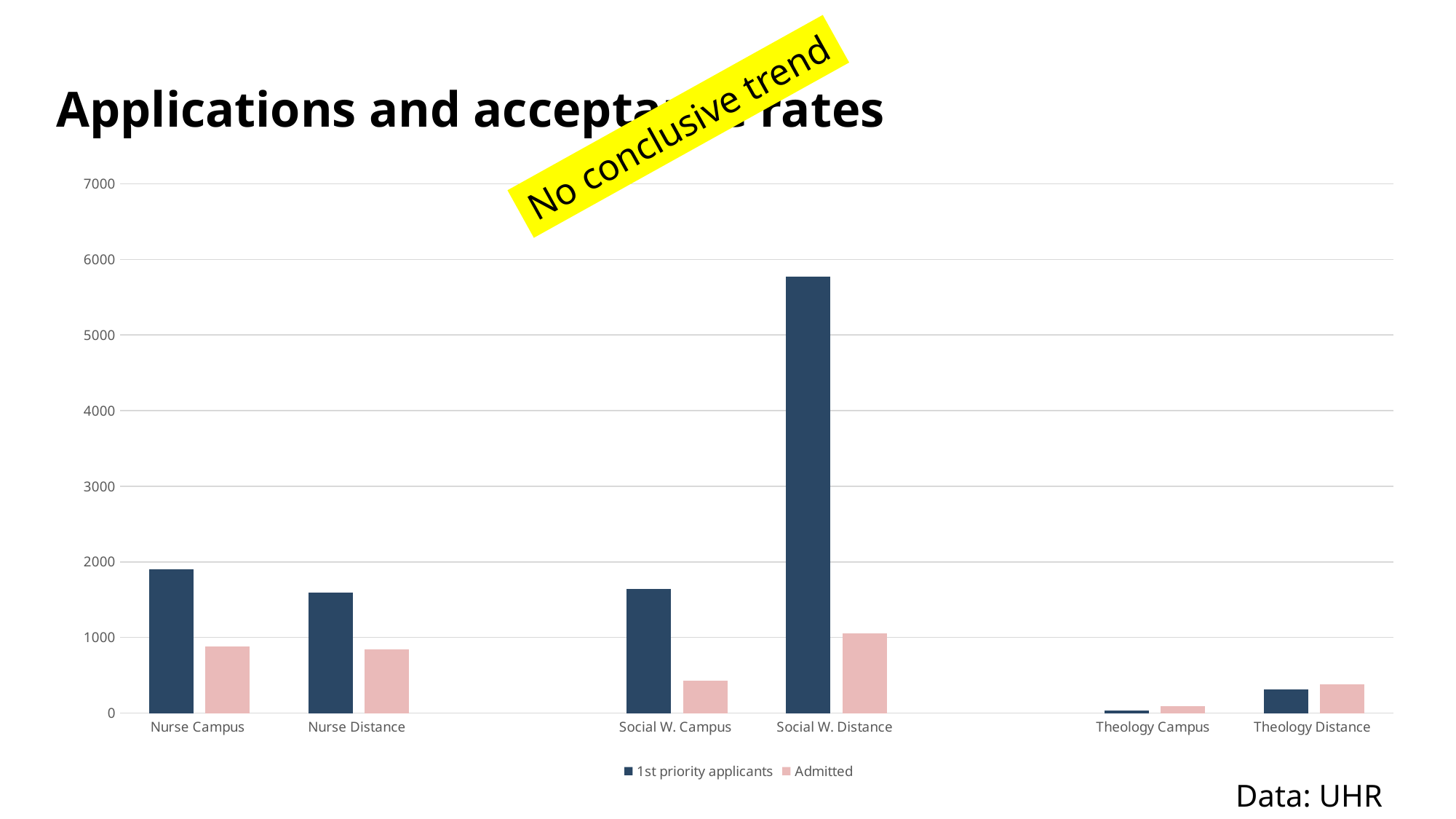
How many series does the legend list? 2 For Theology Campus, which is larger: 1st priority applicants or Admitted? Admitted Which category has the highest number of 1st priority applicants? Social W. Distance How many categories are shown on the x axis? 6 Is the Admitted value for Social W. Campus greater or less than 1000? less Which category has the lowest number of 1st priority applicants? Theology Campus Which is larger: 1st priority applicants for Nurse Campus or for Nurse Distance? Nurse Campus Is the value for 1st priority applicants at Nurse Campus greater or less than 2000? less Is the value for 1st priority applicants at Social W. Distance greater or less than 5000? greater What does the yellow sticker on the slide say? No conclusive trend Which category has the highest Admitted value? Social W. Distance What kind of chart is shown on the slide? Bar chart